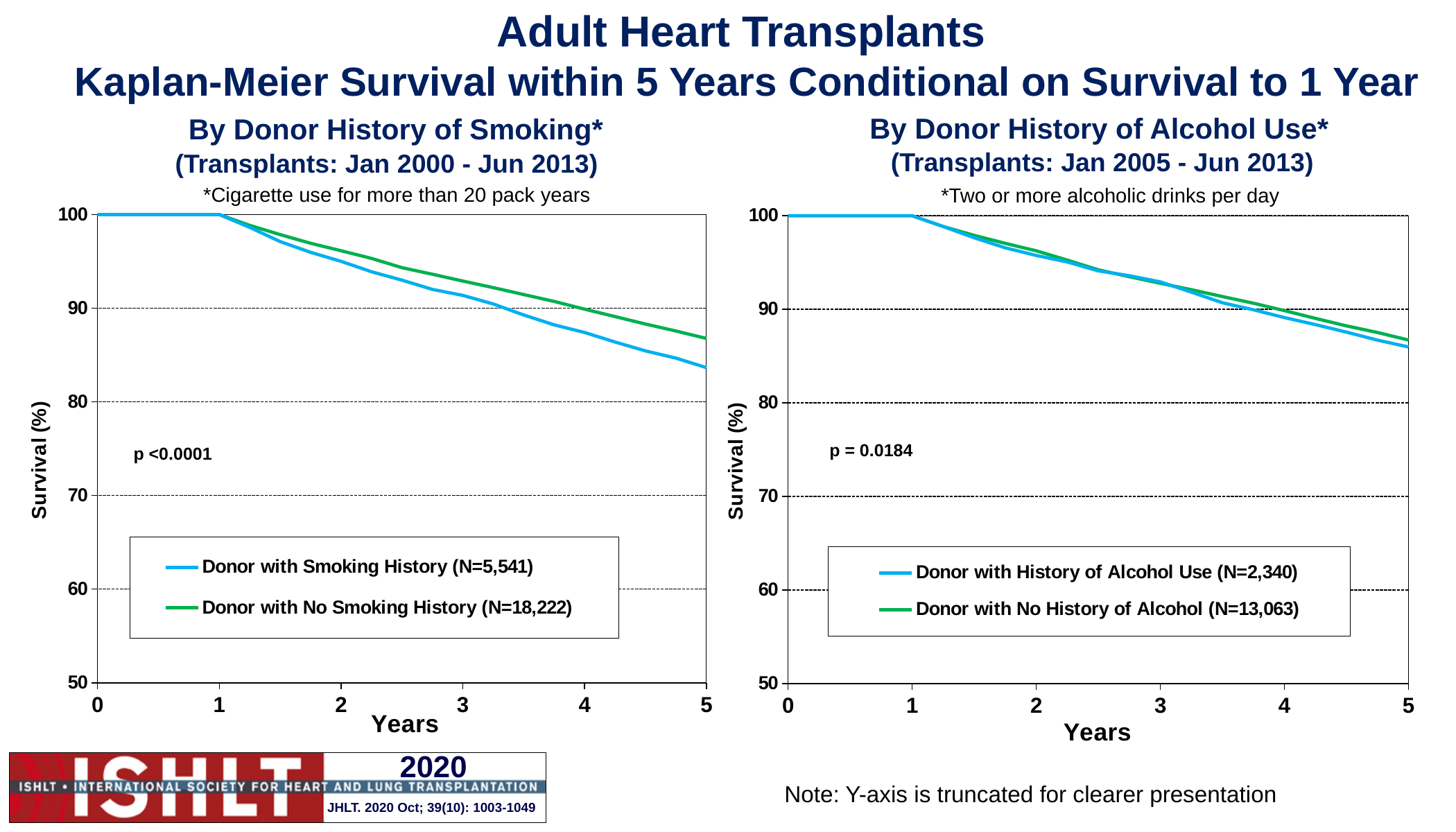
In the left chart, 'By Donor History of Smoking', how many series does the legend list? 2 In the right chart, 'By Donor History of Alcohol Use', does survival rise or fall as years increase? Fall What p-value is shown on the left chart, 'By Donor History of Smoking'? p <0.0001 In the left chart, 'By Donor History of Smoking', which series has higher survival at year 5? Donor with No Smoking History (N=18,222) In the left chart, 'By Donor History of Smoking', what is the survival (%) for Donor with Smoking History at year 1? 100 What kind of chart is the left chart, 'By Donor History of Smoking'? Line chart In the right chart, 'By Donor History of Alcohol Use', how many series does the legend list? 2 In the left chart, 'By Donor History of Smoking', is the survival for Donor with Smoking History at year 5 greater or less than 90? less In the left chart, 'By Donor History of Smoking', is the survival for Donor with No Smoking History at year 2 greater or less than 90? greater In the left chart, 'By Donor History of Smoking', does survival rise or fall as years increase? Fall In the right chart, 'By Donor History of Alcohol Use', what is the N for Donor with No History of Alcohol according to the legend? 13,063 In the right chart, 'By Donor History of Alcohol Use', is the survival for Donor with History of Alcohol Use at year 5 greater or less than 90? less